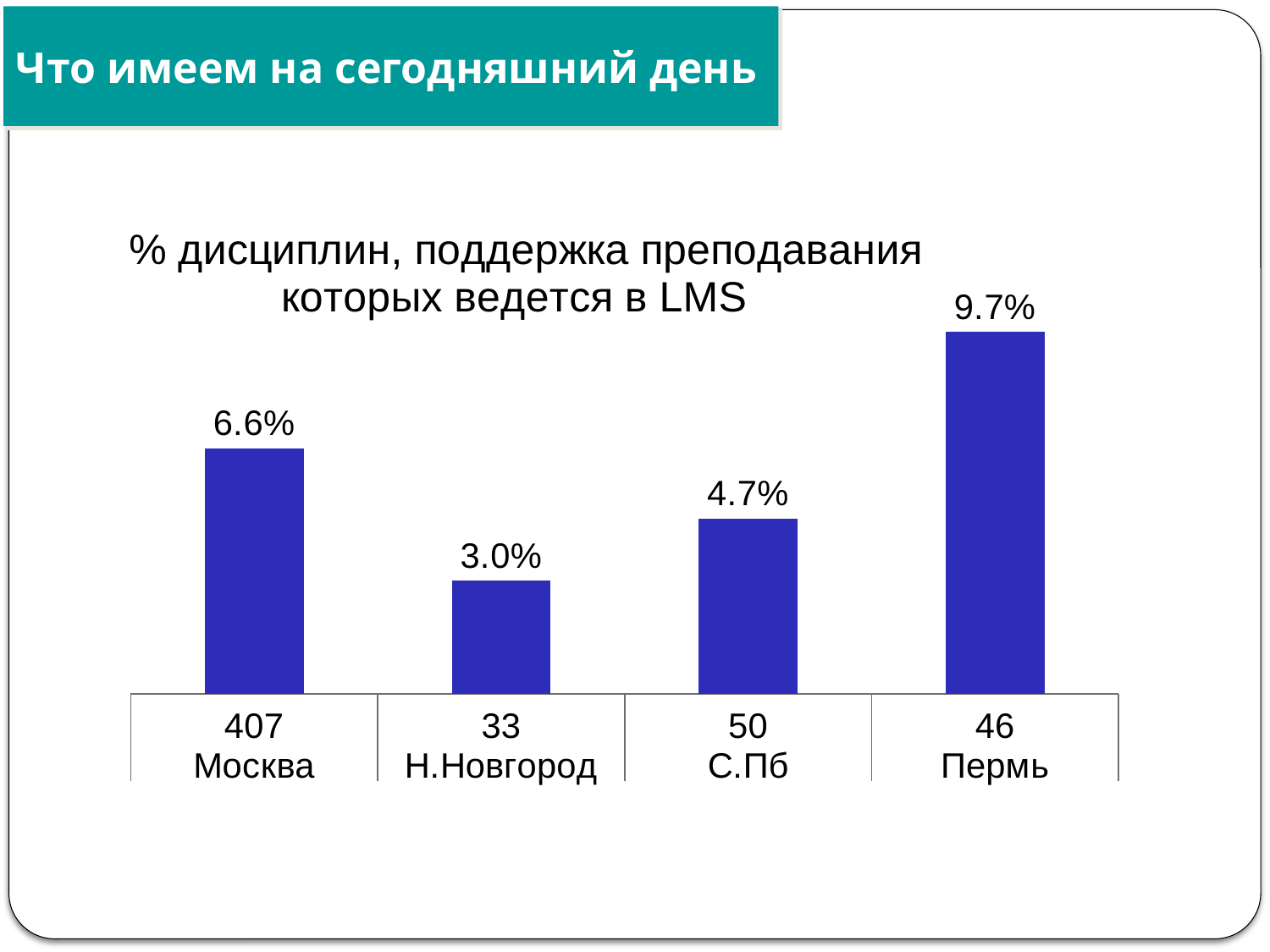
How many categories are shown in the chart? 4 What is the value for С.Пб? 4.7% Which category has the highest value? Пермь Which category has the lowest value? Н.Новгород What is the value for Н.Новгород? 3.0% What is the value for Москва? 6.6% What kind of chart is shown on the slide? Bar chart What is the difference between the values for С.Пб and Н.Новгород? 1.7% What is the title of the chart? % дисциплин, поддержка преподавания которых ведется в LMS What is the difference between the values for Пермь and Москва? 3.1% Which is larger, the value for Москва or the value for С.Пб? Москва What is the value for Пермь? 9.7%